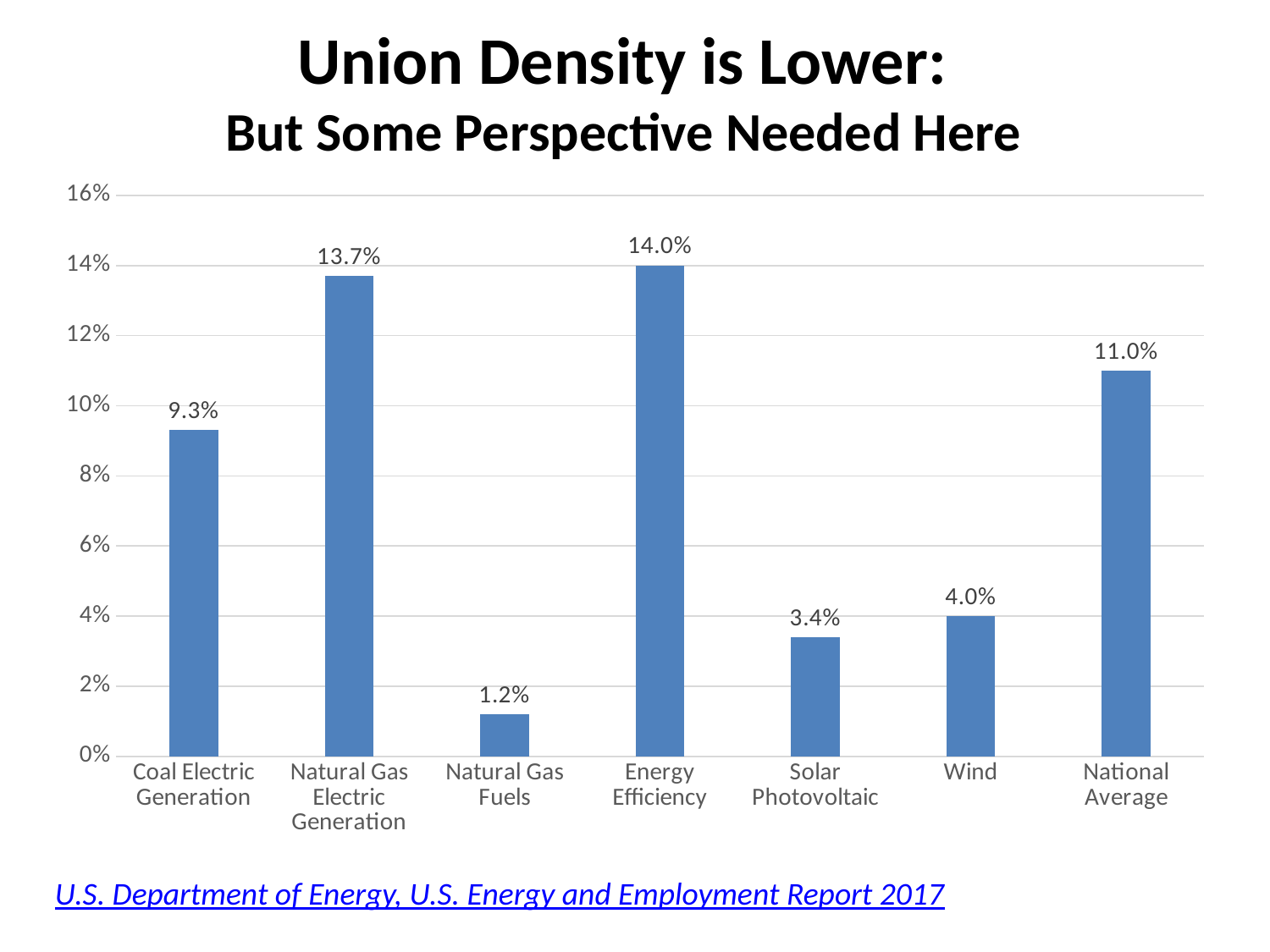
What is the value for the National Average? 11.0% What kind of chart is shown on the slide? bar chart Which is larger, the value for Coal Electric Generation or the value for the National Average? National Average What is the value for Natural Gas Fuels? 1.2% What is the difference between the values for Energy Efficiency and Natural Gas Electric Generation? 0.3% What is the title of the chart on the slide? Union Density is Lower: But Some Perspective Needed Here Which category has the lowest value? Natural Gas Fuels Is the value for Solar Photovoltaic greater or less than 4%? less How many categories are shown on the x axis? 7 What is the difference between the values for Wind and Solar Photovoltaic? 0.6% Which category has the highest value? Energy Efficiency What is the value for Coal Electric Generation? 9.3%